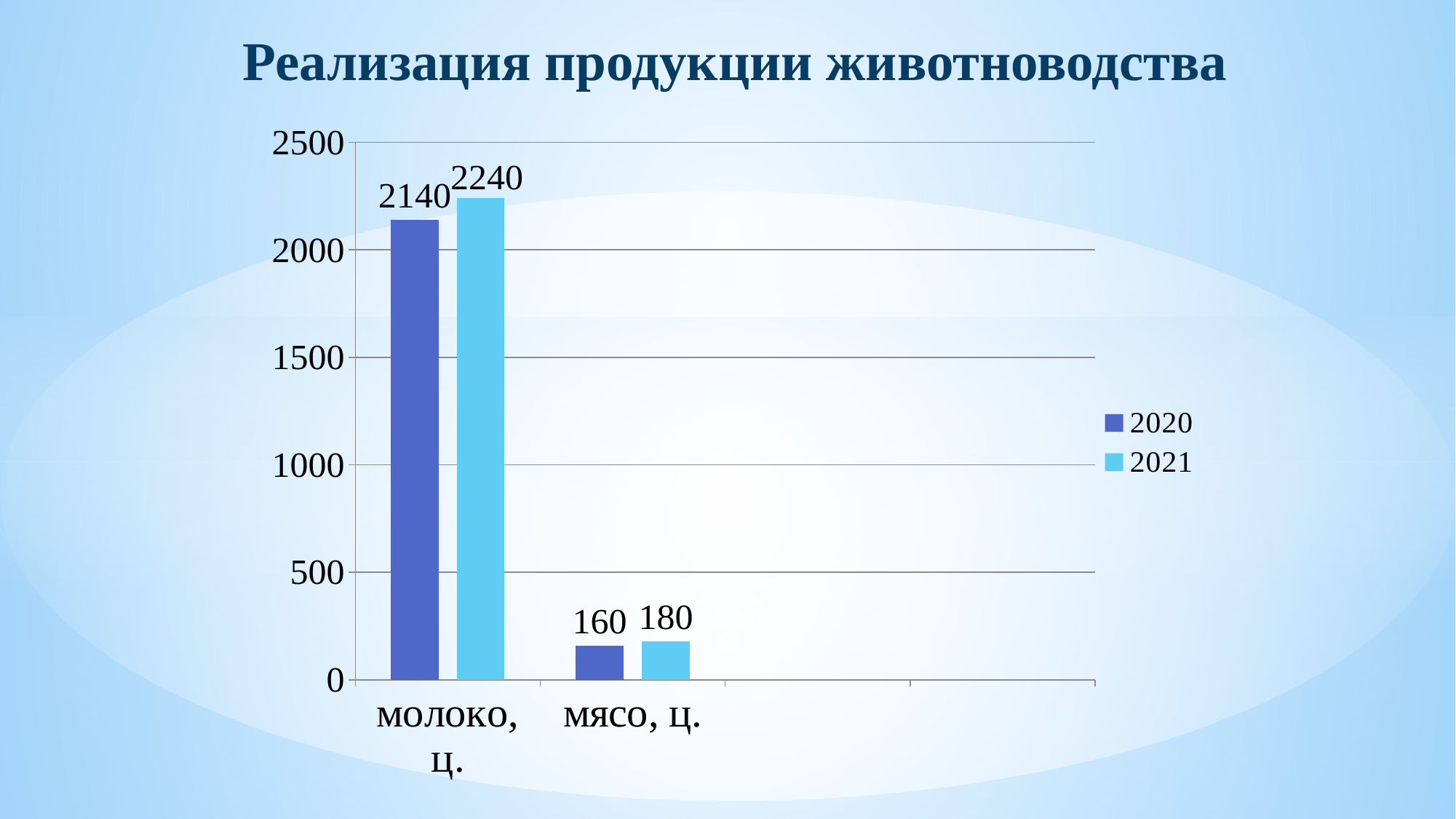
Which category has the lowest value in the 2020 series? мясо, ц. What is the value for мясо, ц. in 2020? 160 What is the difference between the 2021 and 2020 values for мясо, ц.? 20 How many series does the legend list? 2 How many categories are shown on the x axis? 2 What is the value for молоко, ц. in 2020? 2140 Which is larger for мясо, ц.: the 2020 value or the 2021 value? 2021 What is the value for мясо, ц. in 2021? 180 Which category has the highest value in the 2021 series? молоко, ц. What kind of chart is shown on the slide? bar chart What is the difference between the 2021 and 2020 values for молоко, ц.? 100 What is the value for молоко, ц. in 2021? 2240